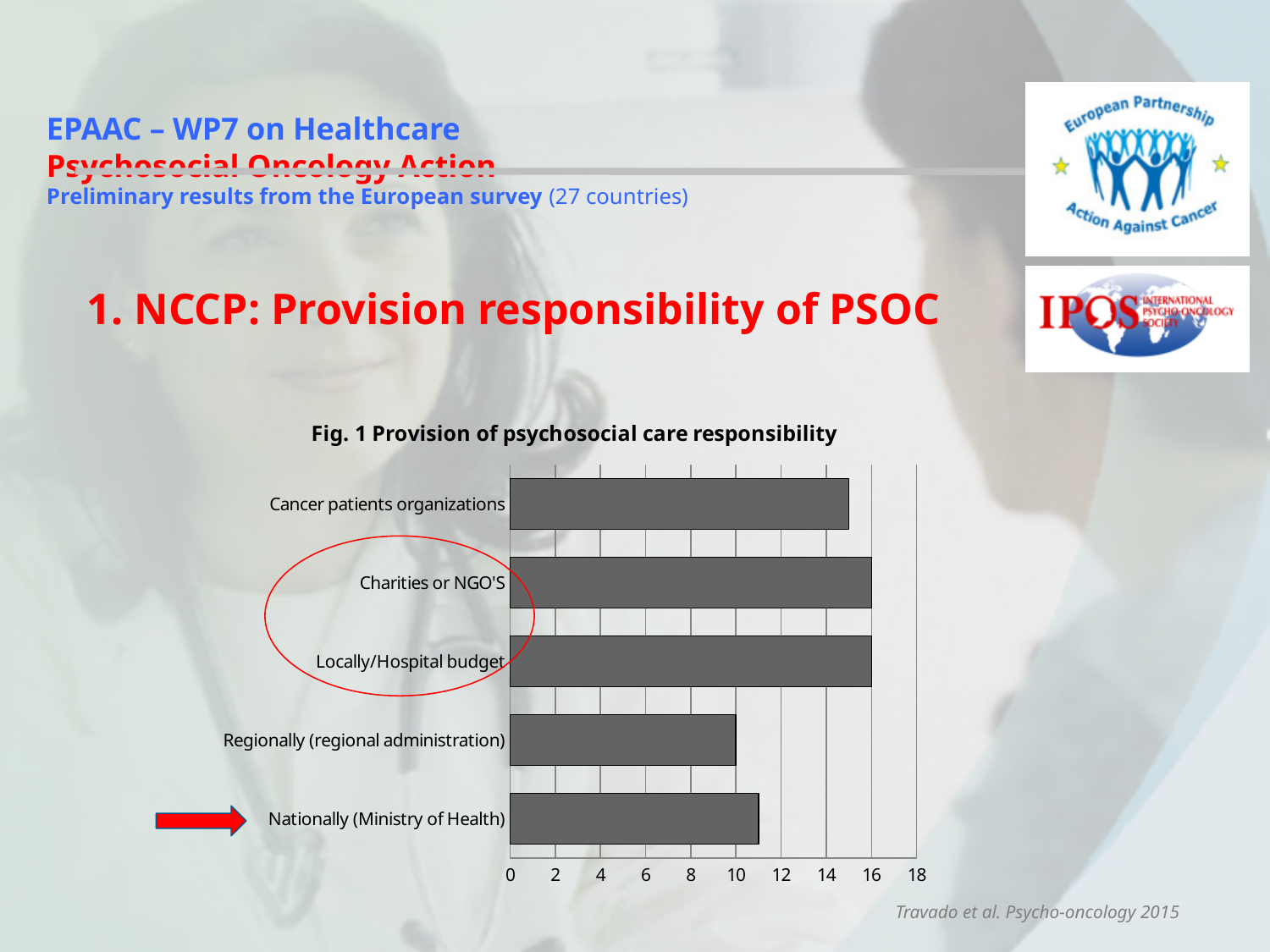
How many categories are plotted in the chart? 5 What is the value for Charities or NGO'S? 16 Which is larger, the value for Charities or NGO'S or the value for Regionally (regional administration)? Charities or NGO'S Is the value for Nationally (Ministry of Health) greater or less than 12? less What is the difference between the values for Locally/Hospital budget and Regionally (regional administration)? 6 What is the value for Regionally (regional administration)? 10 Which category has the lowest value? Regionally (regional administration) What type of chart is shown on the slide? Bar chart What is the value for Locally/Hospital budget? 16 Is the value for Cancer patients organizations greater or less than 14? greater What is the title of the chart? Fig. 1 Provision of psychosocial care responsibility Which two categories are circled in red on the chart? Charities or NGO'S and Locally/Hospital budget